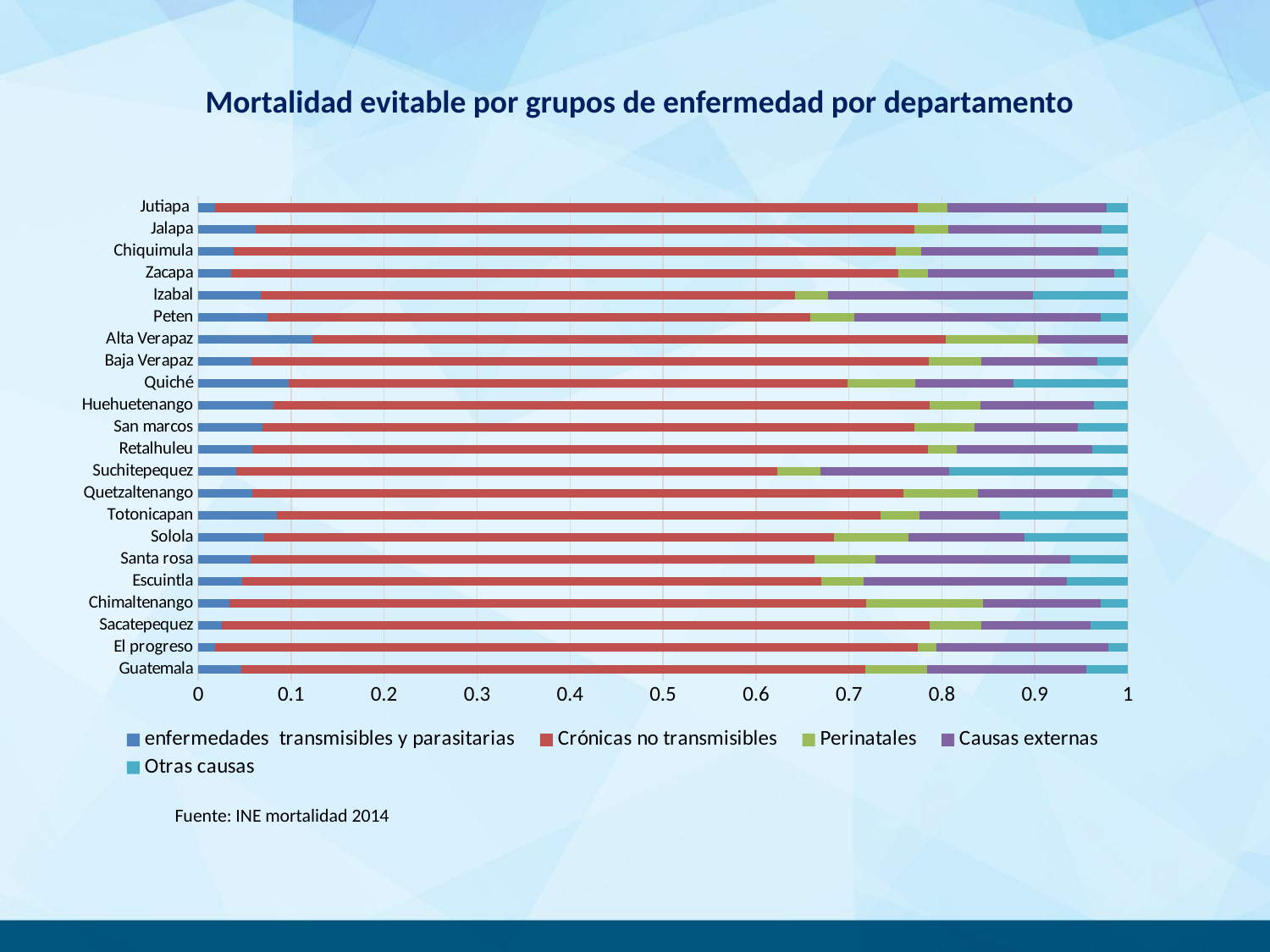
Which has the larger 'enfermedades transmisibles y parasitarias' segment, Alta Verapaz or Jutiapa? Alta Verapaz Is the 'enfermedades transmisibles y parasitarias' value for Jutiapa greater or less than 0.1? less What is the title of the chart? Mortalidad evitable por grupos de enfermedad por departamento Is the 'enfermedades transmisibles y parasitarias' value for Alta Verapaz greater or less than 0.1? greater Which series is shown in red in the chart? Crónicas no transmisibles Which has the larger 'Otras causas' segment, Suchitepequez or Guatemala? Suchitepequez How many departments are listed on the vertical axis of the chart? 22 What is the total of the stacked bar for Guatemala? 1 How many series does the legend list? 5 Which department has the largest 'Otras causas' segment? Suchitepequez Which department has the largest 'enfermedades transmisibles y parasitarias' segment? Alta Verapaz What kind of chart is shown on the slide? Stacked bar chart